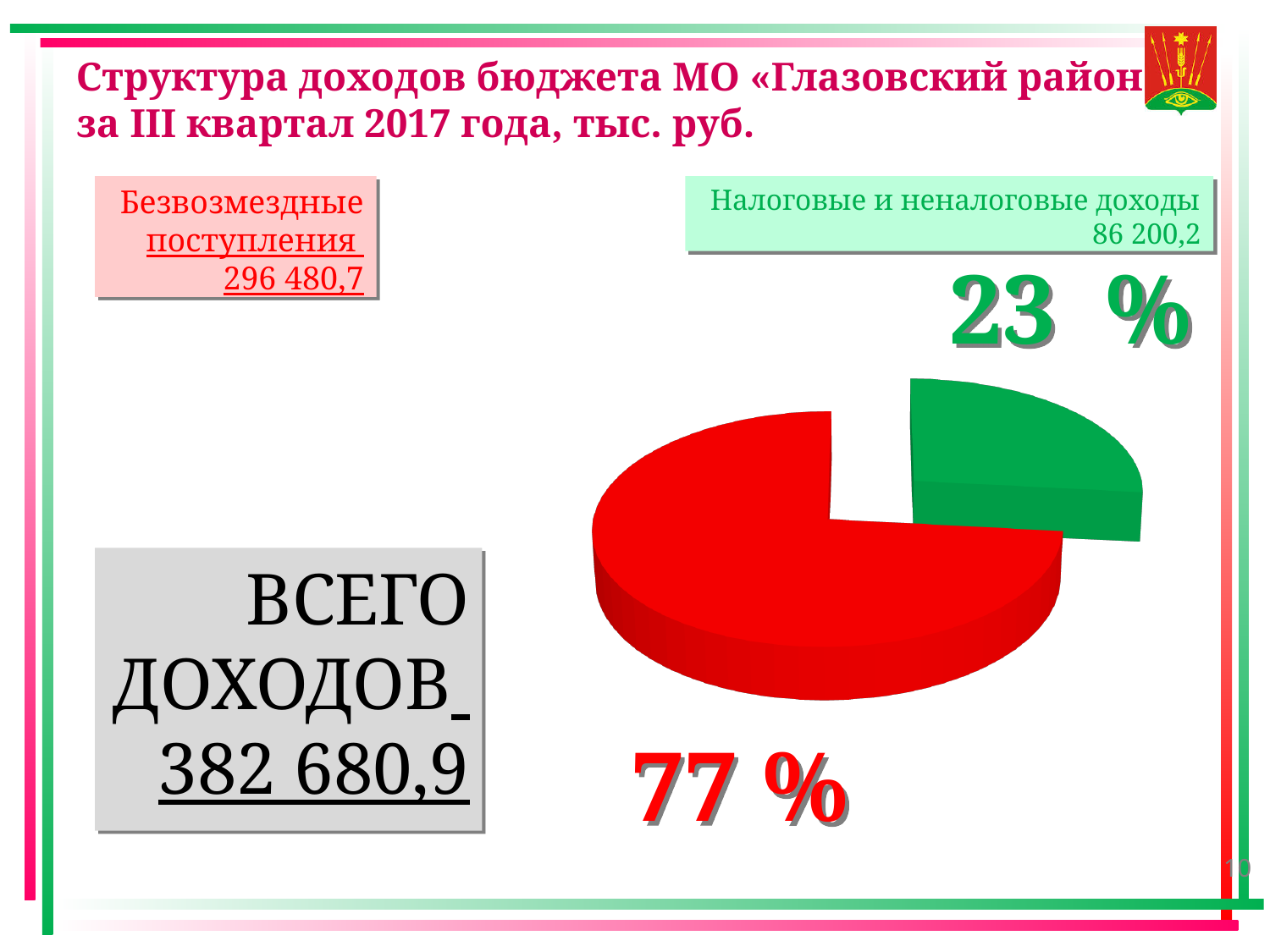
Which category has the largest share of the pie? Безвозмездные поступления Which category has the smallest share of the pie? Налоговые и неналоговые доходы How many slices does the pie chart have? 2 What is the total of all income (ВСЕГО ДОХОДОВ) shown on the slide? 382 680,9 What kind of chart is shown on the slide? pie chart What is the value shown for Безвозмездные поступления? 296 480,7 What is the value shown for Налоговые и неналоговые доходы? 86 200,2 What is the difference in percentage points between the two slices of the pie? 54 What share of the pie does the red slice (Безвозмездные поступления) represent? 77 % What colour is the slice for Налоговые и неналоговые доходы? green Which is larger: Безвозмездные поступления or Налоговые и неналоговые доходы? Безвозмездные поступления What share of the pie does the green slice (Налоговые и неналоговые доходы) represent? 23 %